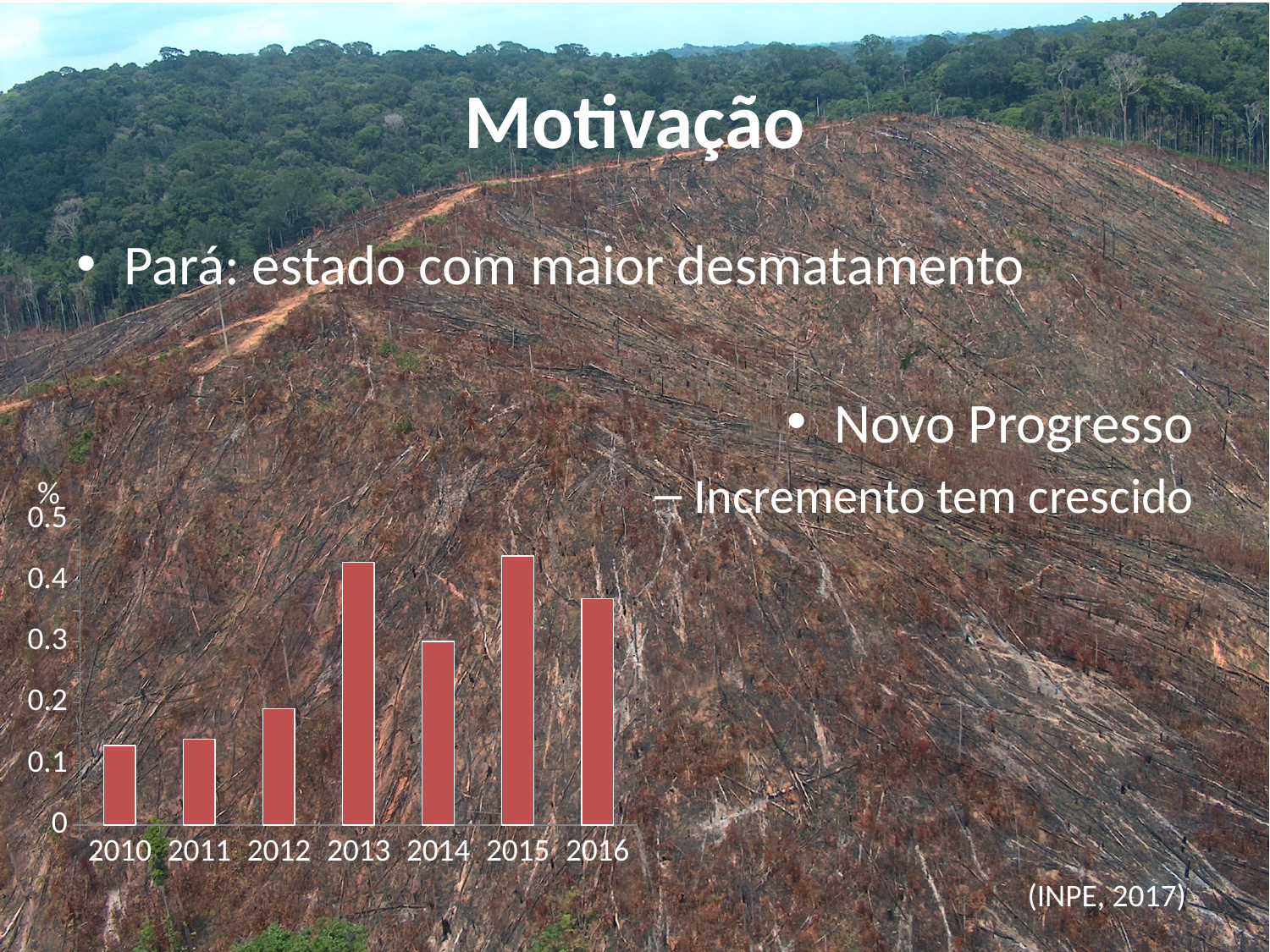
Is the value for 2011 greater or less than 0.2? less Which year has the larger value, 2012 or 2016? 2016 What unit is shown at the top of the y axis? % Is the value for 2016 greater or less than 0.3? greater What is the first year shown on the x axis? 2010 Is the value for 2015 greater or less than 0.4? greater Which year has the larger value, 2013 or 2014? 2013 Do the values generally rise or fall from 2010 to 2016? rise How many years are shown on the x axis of the chart? 7 What kind of chart is shown on the slide? bar chart